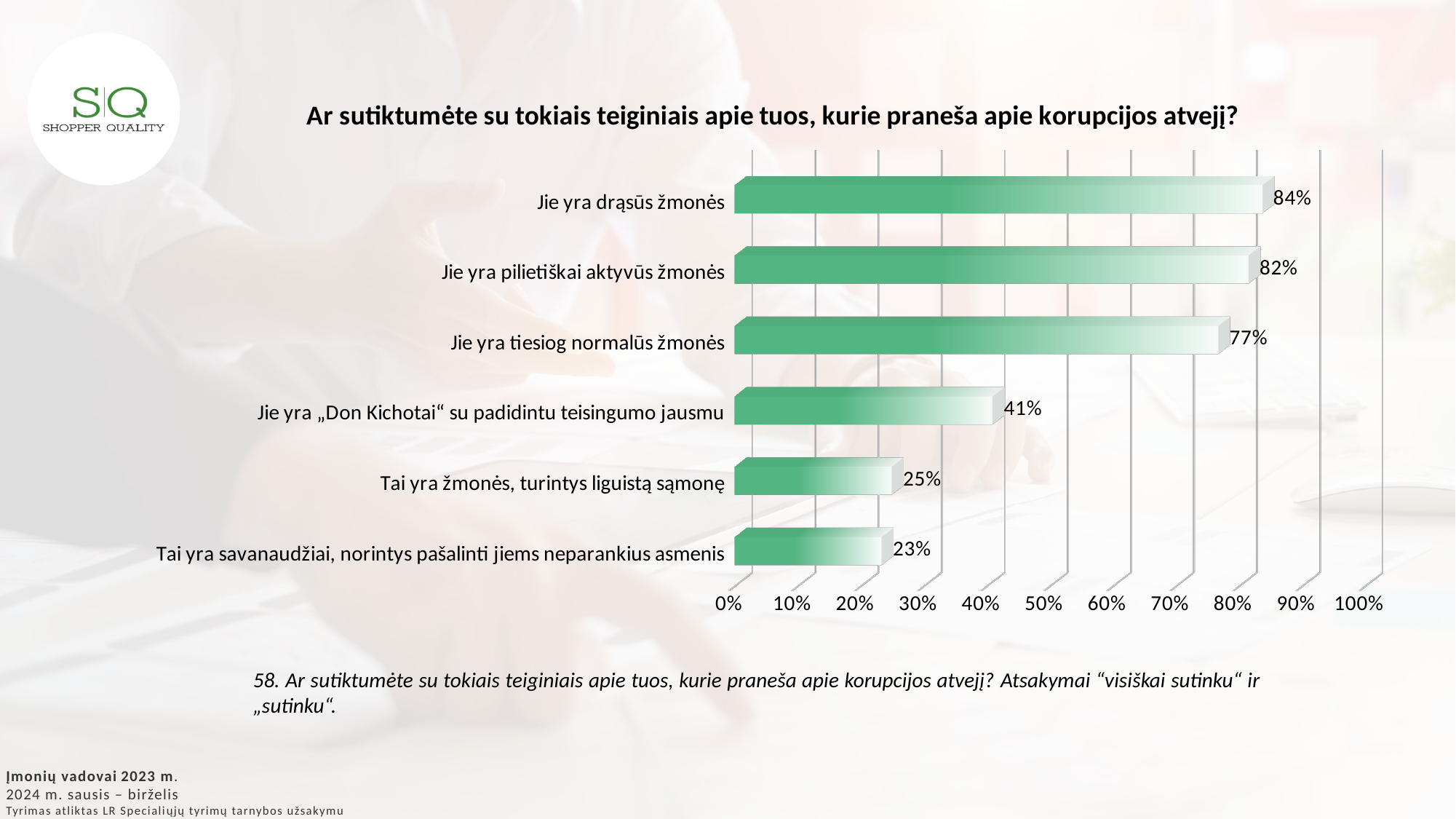
What is the value for "Tai yra savanaudžiai, norintys pašalinti jiems neparankius asmenis"? 23% Which is larger: the value for "Jie yra pilietiškai aktyvūs žmonės" or for "Jie yra tiesiog normalūs žmonės"? Jie yra pilietiškai aktyvūs žmonės What kind of chart is shown on the slide? bar chart Which category has the lowest value? Tai yra savanaudžiai, norintys pašalinti jiems neparankius asmenis Which category has the highest value? Jie yra drąsūs žmonės Is the value for "Tai yra žmonės, turintys liguistą sąmonę" greater or less than 30%? less What is the difference between the values for "Jie yra drąsūs žmonės" and "Jie yra tiesiog normalūs žmonės"? 7% What is the title of the chart? Ar sutiktumėte su tokiais teiginiais apie tuos, kurie praneša apie korupcijos atvejį? What is the value for "Jie yra „Don Kichotai“ su padidintu teisingumo jausmu"? 41% What is the value for "Jie yra drąsūs žmonės"? 84% How many categories are shown in the chart? 6 What is the difference between the values for "Tai yra žmonės, turintys liguistą sąmonę" and "Tai yra savanaudžiai, norintys pašalinti jiems neparankius asmenis"? 2%